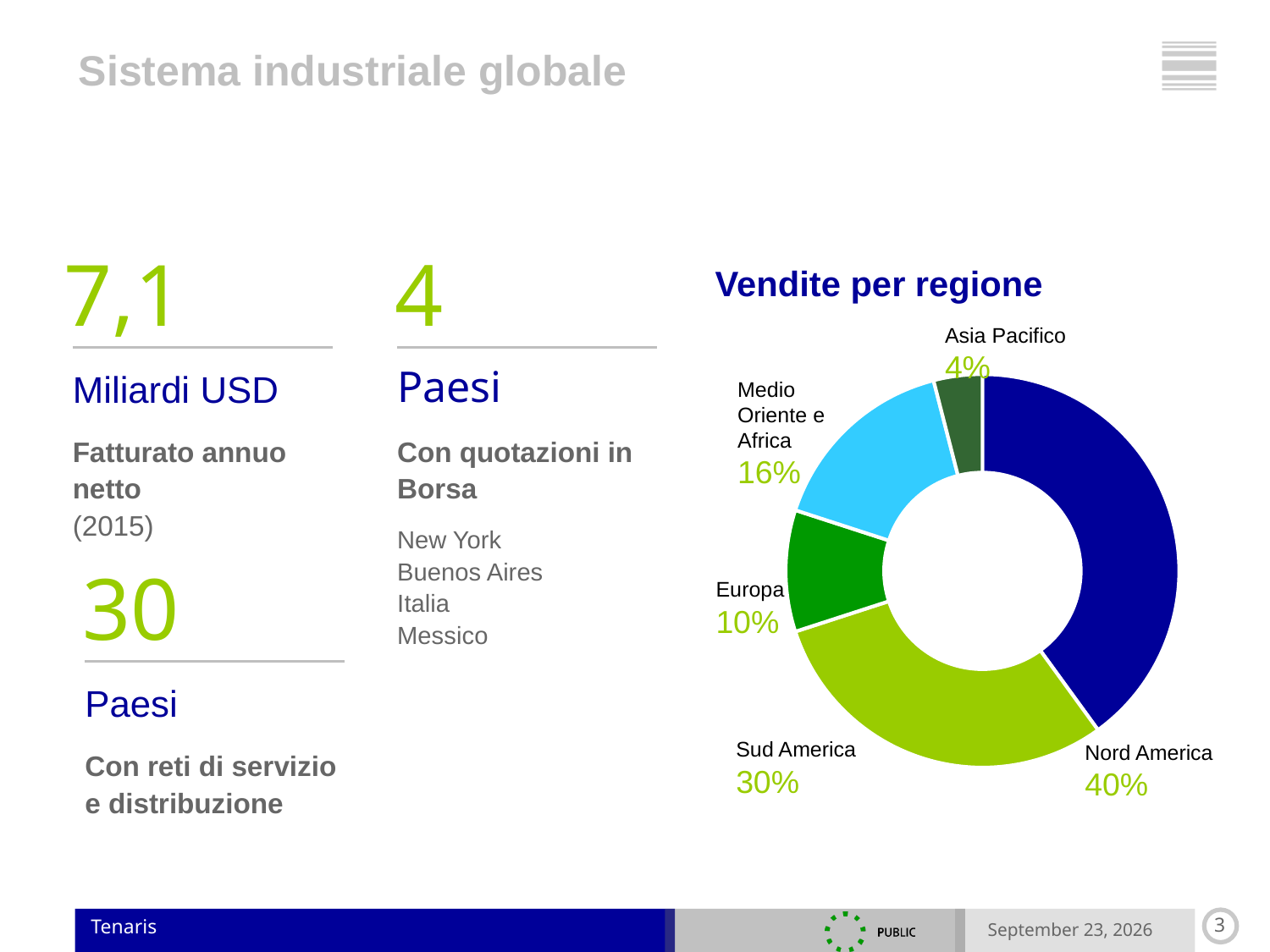
What is the difference in percentage points between Nord America and Sud America in the 'Vendite per regione' chart? 10 What share of sales does Medio Oriente e Africa account for in the 'Vendite per regione' chart? 16% How many regions are shown in the 'Vendite per regione' chart? 5 Which region has the largest share in the 'Vendite per regione' chart? Nord America What share of sales does Nord America account for in the 'Vendite per regione' chart? 40% Which has a larger share in the 'Vendite per regione' chart, Europa or Medio Oriente e Africa? Medio Oriente e Africa Which region has the smallest share in the 'Vendite per regione' chart? Asia Pacifico What kind of chart is 'Vendite per regione'? Doughnut chart What share of sales does Asia Pacifico account for in the 'Vendite per regione' chart? 4% What share of sales does Sud America account for in the 'Vendite per regione' chart? 30% What share of sales does Europa account for in the 'Vendite per regione' chart? 10% What is the title of the chart on the slide? Vendite per regione